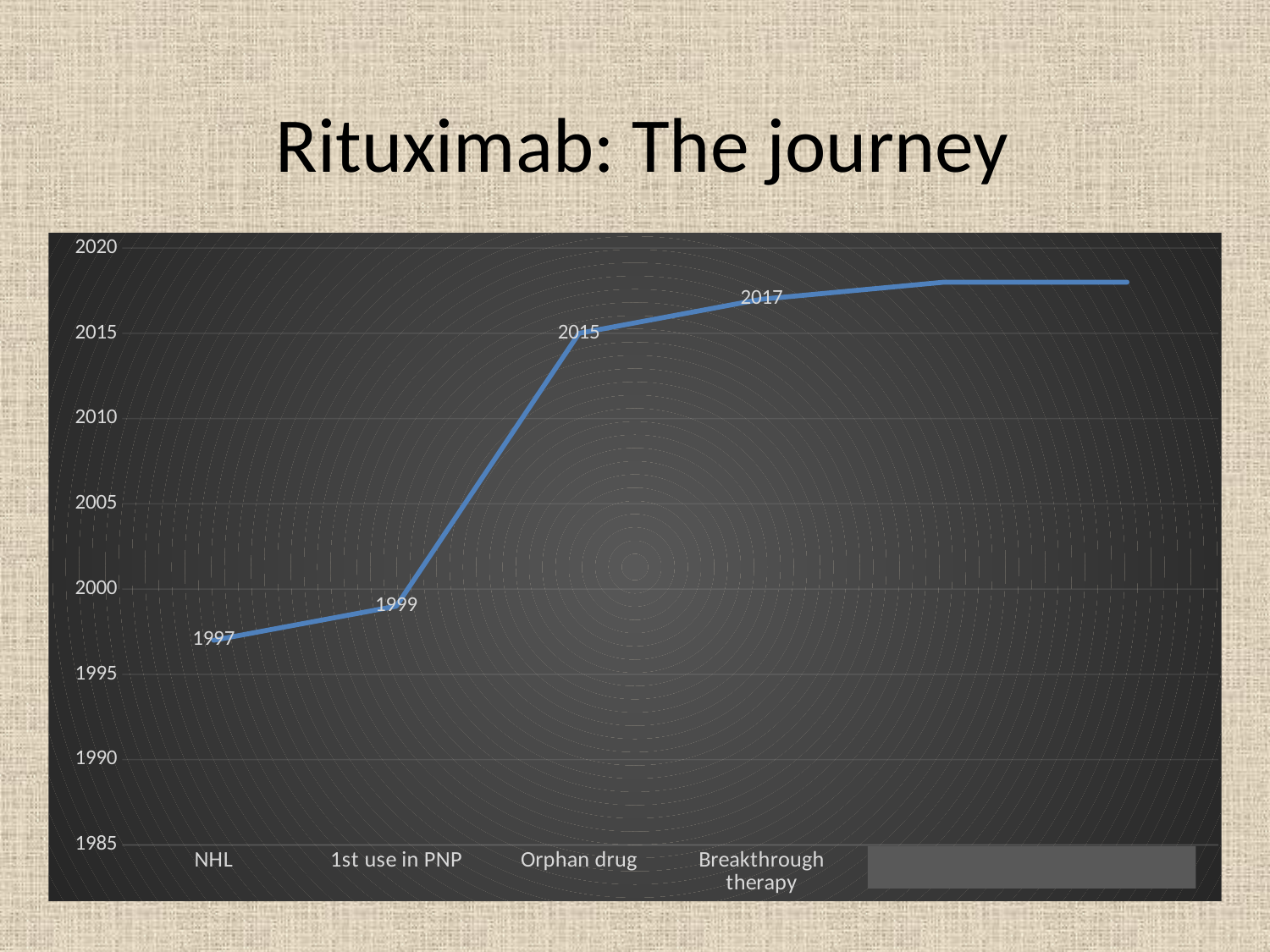
Do the values rise or fall from left to right along the x axis? rise Which is larger, the value for Orphan drug or the value for 1st use in PNP? Orphan drug What value is shown for 1st use in PNP? 1999 Which category has the lowest value? NHL What is the difference between the values for Breakthrough therapy and NHL? 20 Is the value for NHL greater or less than 2000? less What value is shown for Orphan drug? 2015 What kind of chart is shown on the slide? line chart What is the difference between the values for Orphan drug and 1st use in PNP? 16 What is the title of the chart? Rituximab: The journey What value is shown for Breakthrough therapy? 2017 What value is shown for NHL? 1997